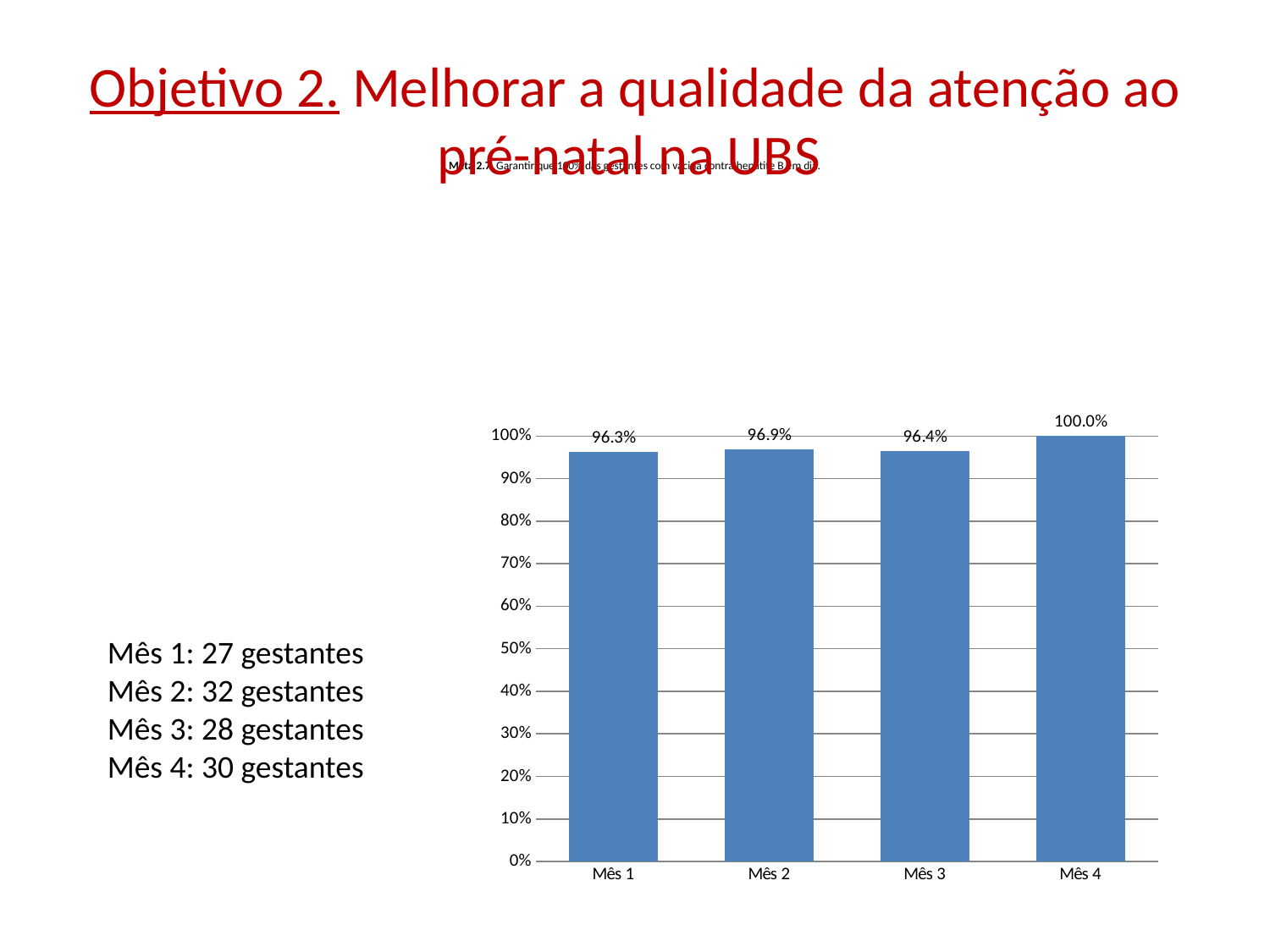
What is the difference between the values for Mês 4 and Mês 1? 3.7% What is the value for Mês 2? 96.9% What is the value for Mês 4? 100.0% What is the value for Mês 3? 96.4% Is the value for Mês 1 greater or less than 90%? greater Which is larger, the value for Mês 2 or the value for Mês 3? Mês 2 How many months are shown on the x axis? 4 What is the value for Mês 1? 96.3% What is the difference between the values for Mês 2 and Mês 1? 0.6% What kind of chart is shown on the slide? bar chart Which month has the highest value? Mês 4 Which month has the lowest value? Mês 1